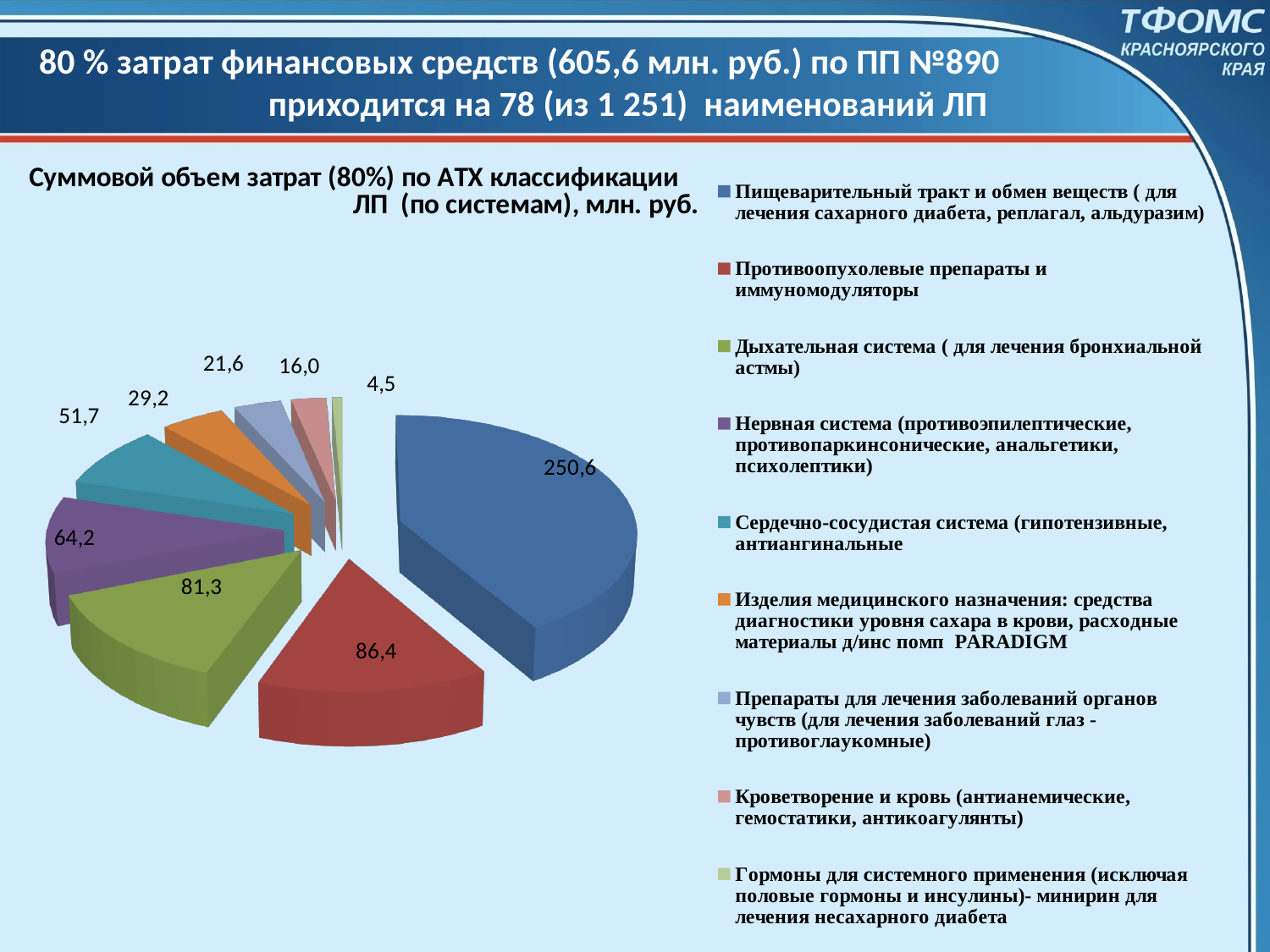
What is the value for Нервная система? 64,2 What is the value for Дыхательная система? 81,3 What kind of chart is shown on the slide? Pie chart Which is larger: the value for Изделия медицинского назначения or the value for Препараты для лечения заболеваний органов чувств? Изделия медицинского назначения What is the value for Сердечно-сосудистая система? 51,7 What is the value for Противоопухолевые препараты и иммуномодуляторы? 86,4 Which category has the largest slice in the pie chart? Пищеварительный тракт и обмен веществ How many categories does the legend list? 9 What is the difference between the values for Пищеварительный тракт и обмен веществ and Противоопухолевые препараты и иммуномодуляторы? 164,2 Which category has the smallest slice in the pie chart? Гормоны для системного применения What is the value for Пищеварительный тракт и обмен веществ in the pie chart? 250,6 What is the value for Гормоны для системного применения? 4,5